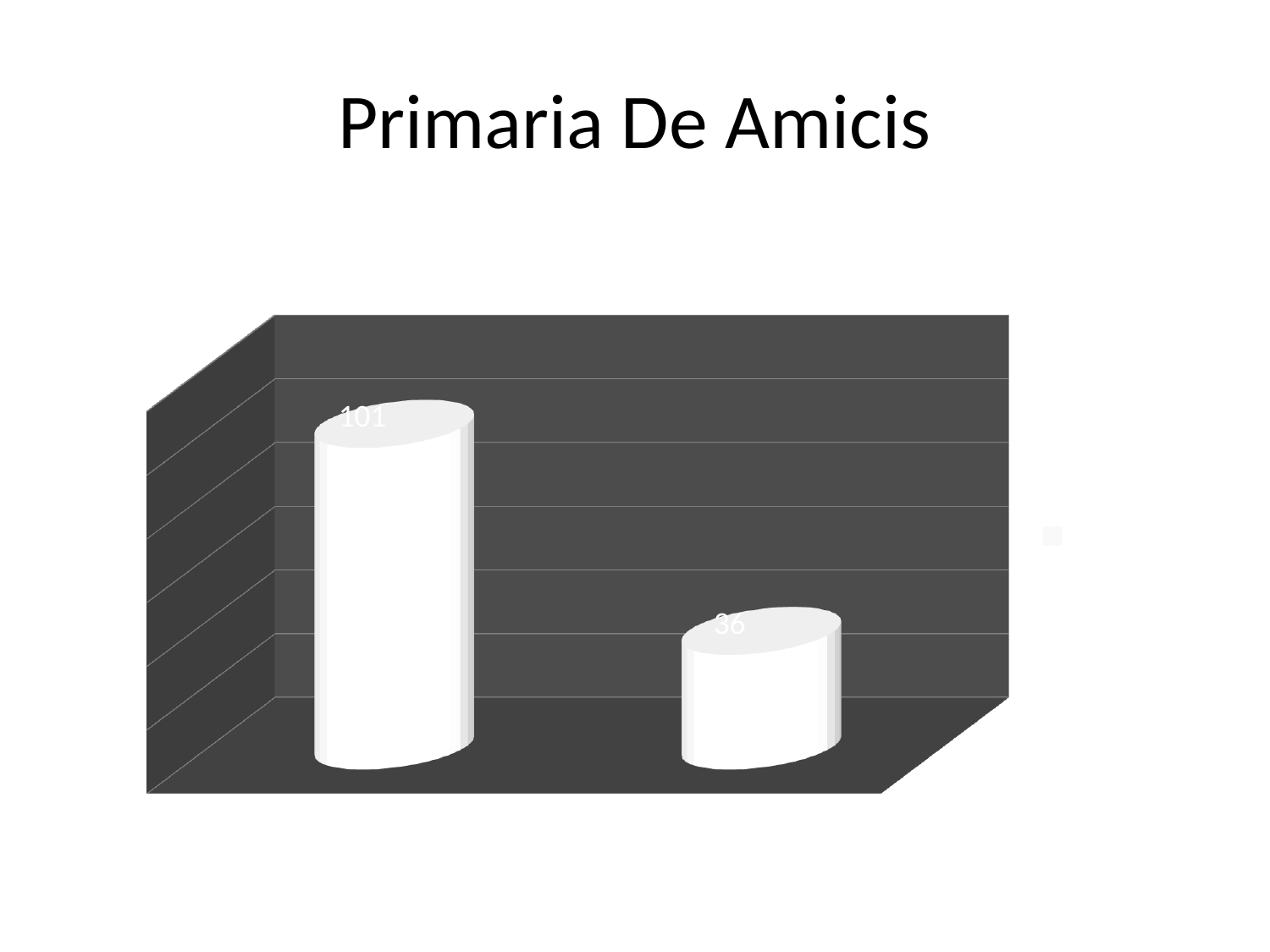
Do the values rise or fall from the left bar to the right bar? fall Is the value of the left bar larger or smaller than the value of the right bar? larger What is the value shown on the right bar of the chart? 36 Which bar has the highest value, the left or the right one? the left bar What colour are the bars in the chart? white What is the difference between the values of the left bar and the right bar? 65 How many bars are plotted in the chart? 2 What is the title of the chart on the slide? Primaria De Amicis What kind of chart is shown on the slide? bar chart What is the value shown on the left bar of the chart? 101 Which bar has the lowest value, the left or the right one? the right bar